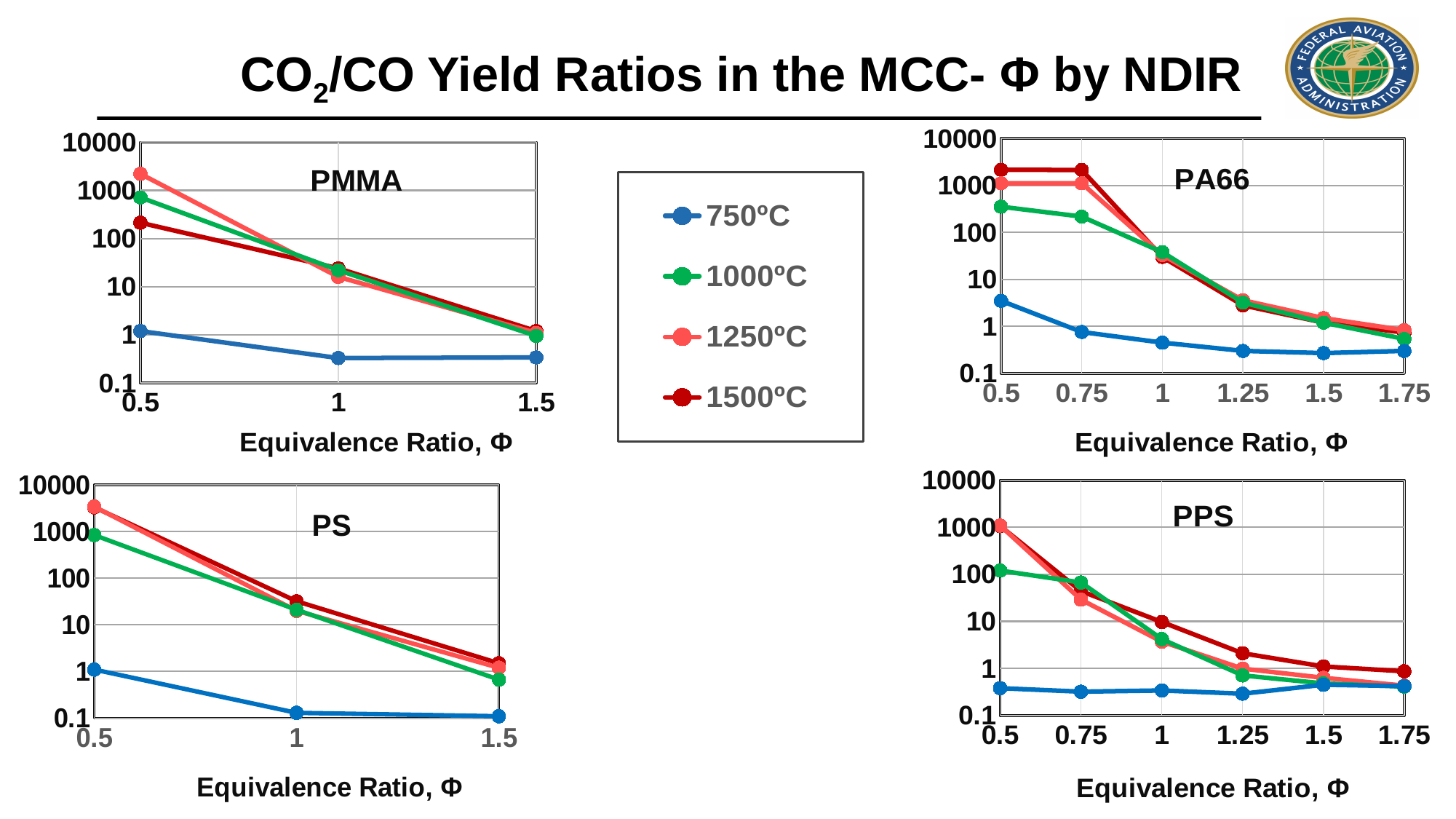
In the PS chart, which series has the lowest value at equivalence ratio 1.5? 750°C In the PA66 chart, how many equivalence ratio points are plotted along the x axis? 6 What kind of chart is the PMMA chart? line chart In the PMMA chart, which series has the highest value at equivalence ratio 0.5? 1250°C In the PPS chart, is the value for 750°C at equivalence ratio 0.5 greater or less than 1? less In the PMMA chart, does the 1000°C series rise or fall as the equivalence ratio increases? fall In the PA66 chart, is the value for 750°C at equivalence ratio 0.5 greater or less than 1? greater In the PMMA chart, is the value for 1250°C at equivalence ratio 0.5 greater or less than 1000? greater In the PMMA chart, how many equivalence ratio points are plotted along the x axis? 3 In the PA66 chart, at equivalence ratio 0.5, which is larger: the 1500°C value or the 1000°C value? 1500°C How many series does the legend list? 4